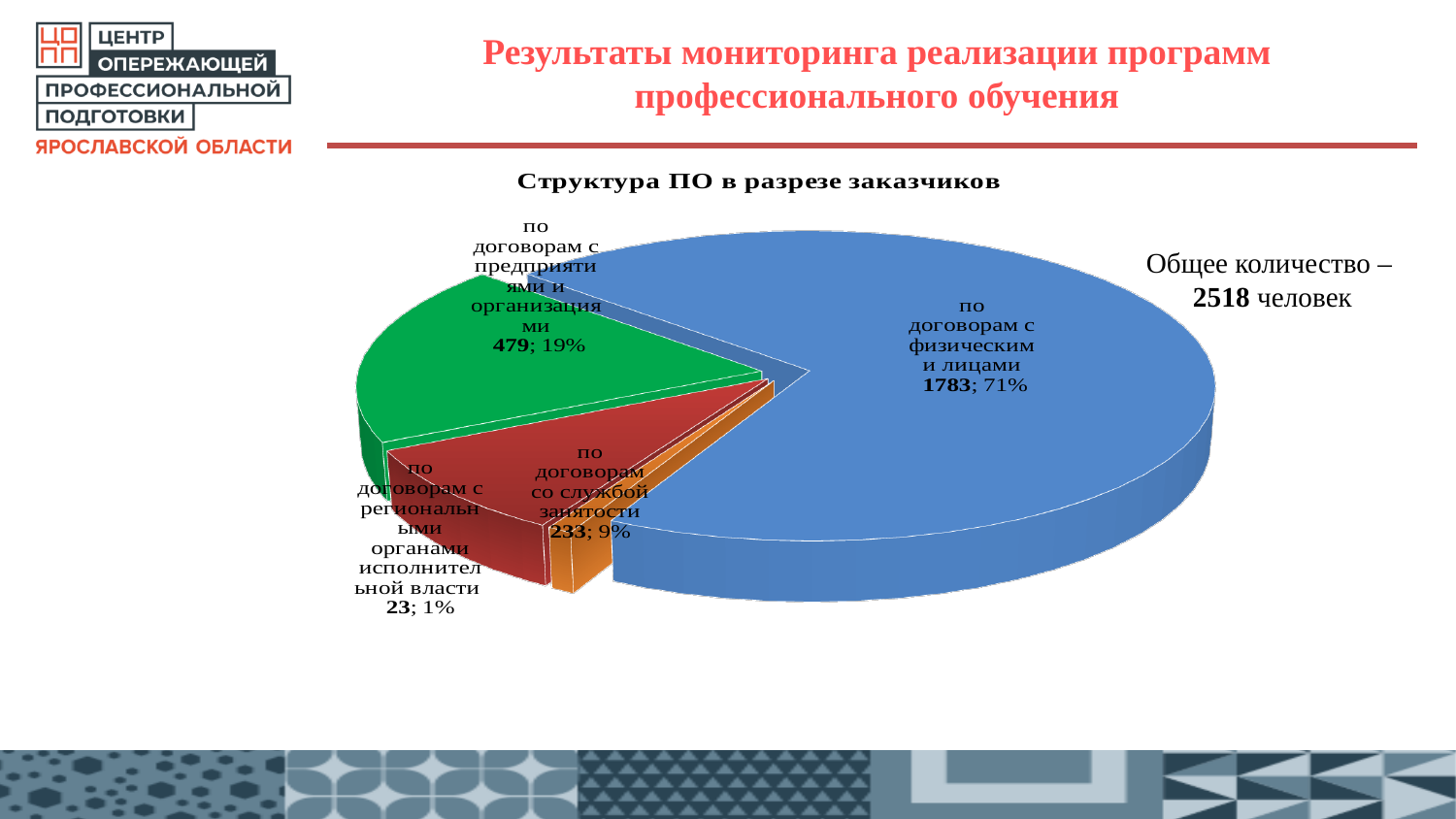
Which category has the smallest slice of the pie? по договорам с региональными органами исполнительной власти What is the value for 'по договорам с физическими лицами'? 1783 What is the value for 'по договорам с региональными органами исполнительной власти'? 23 What is the value for 'по договорам со службой занятости'? 233 What share of the pie does 'по договорам с предприятиями и организациями' represent? 19% What is the difference between the values for 'по договорам с физическими лицами' and 'по договорам со службой занятости'? 1550 Which category has the largest slice of the pie? по договорам с физическими лицами What is the value for 'по договорам с предприятиями и организациями'? 479 Which is larger: the value for 'по договорам со службой занятости' or 'по договорам с предприятиями и организациями'? по договорам с предприятиями и организациями What kind of chart is shown on the slide? pie chart How many slices does the pie chart have? 4 What is the title of the chart? Структура ПО в разрезе заказчиков